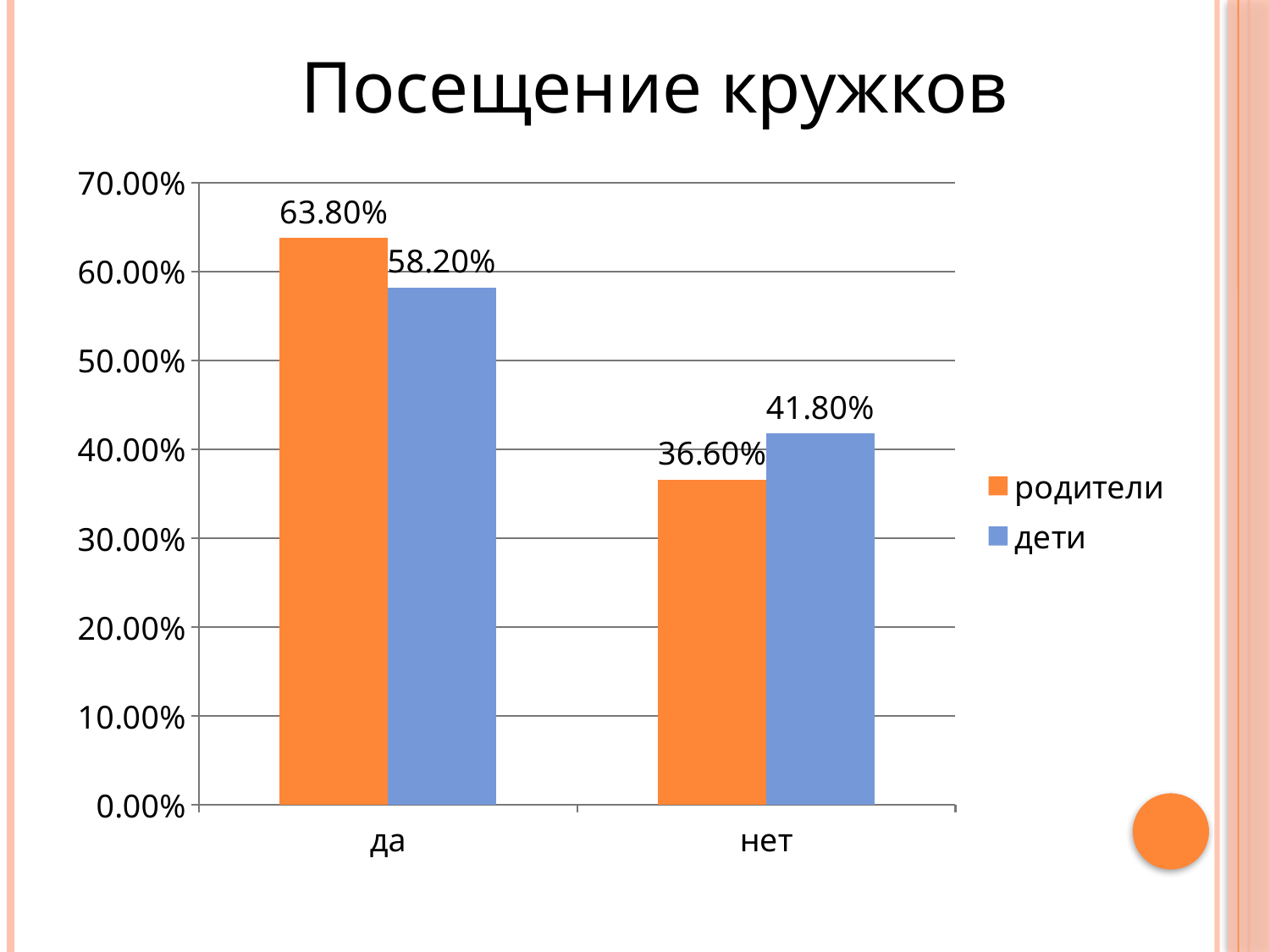
Which category has the lowest value for the дети series? нет How many categories are shown on the x axis? 2 What is the value for дети in the нет category? 41.80% What is the difference between дети and родители in the нет category? 5.20% What is the value for дети in the да category? 58.20% What is the difference between родители and дети in the да category? 5.60% In the нет category, which series has the larger value, родители or дети? дети Which category has the highest value for the родители series? да What kind of chart is shown on the slide? bar chart What is the value for родители in the нет category? 36.60% How many series does the legend list? 2 What is the value for родители in the да category? 63.80%